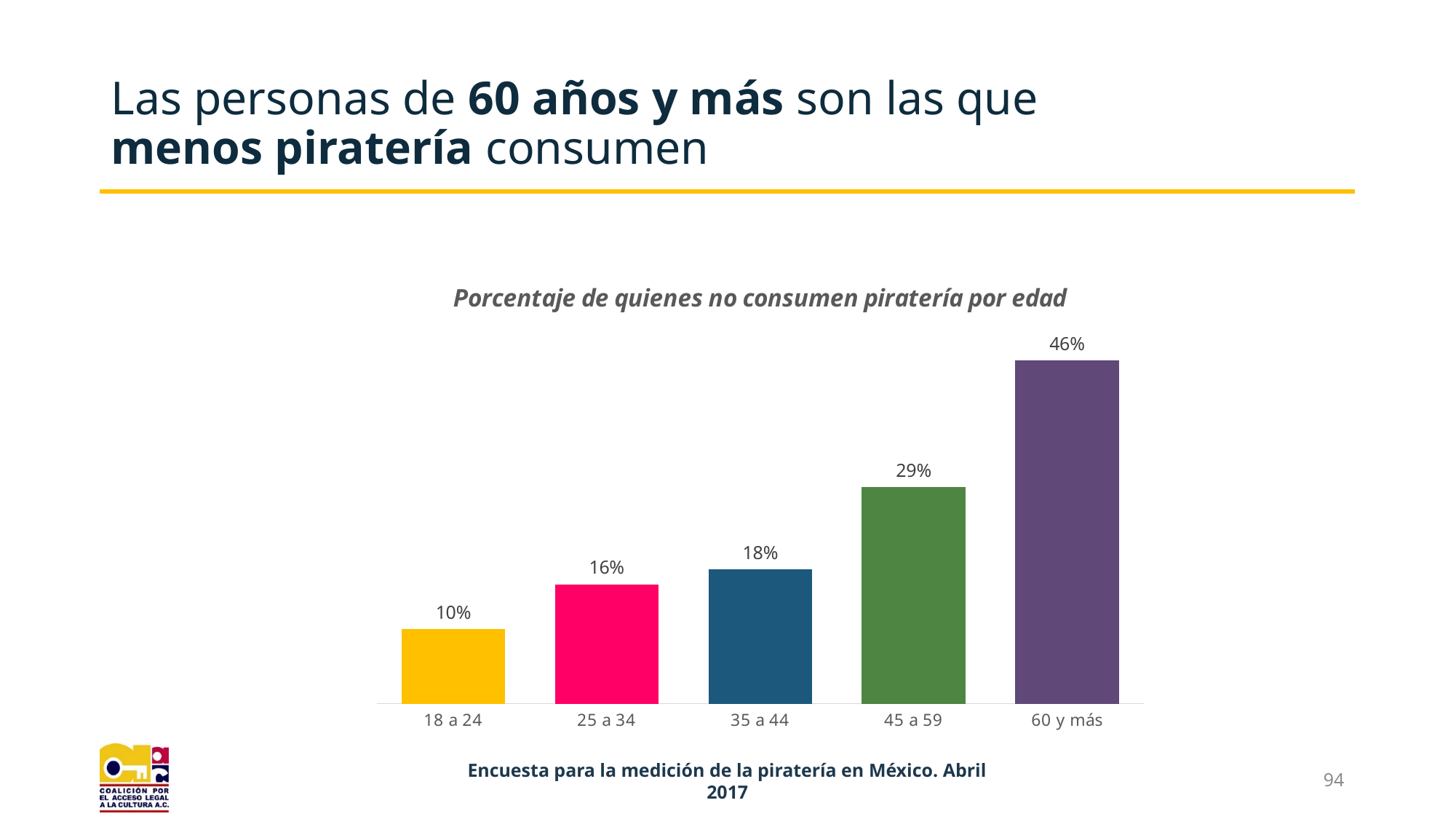
Which is larger, the value for 45 a 59 or the value for 35 a 44? 45 a 59 What is the value for the 60 y más age group? 46% What is the difference between the values for 25 a 34 and 18 a 24? 6% Which age group has the lowest percentage? 18 a 24 How many age groups are shown in the chart? 5 Do the values rise or fall as age increases along the x axis? Rise Which age group has the highest percentage? 60 y más What is the title of the chart? Porcentaje de quienes no consumen piratería por edad What kind of chart is shown on the slide? Bar chart What is the difference between the values for 60 y más and 45 a 59? 17% What is the value for the 35 a 44 age group? 18% What is the value for the 18 a 24 age group? 10%